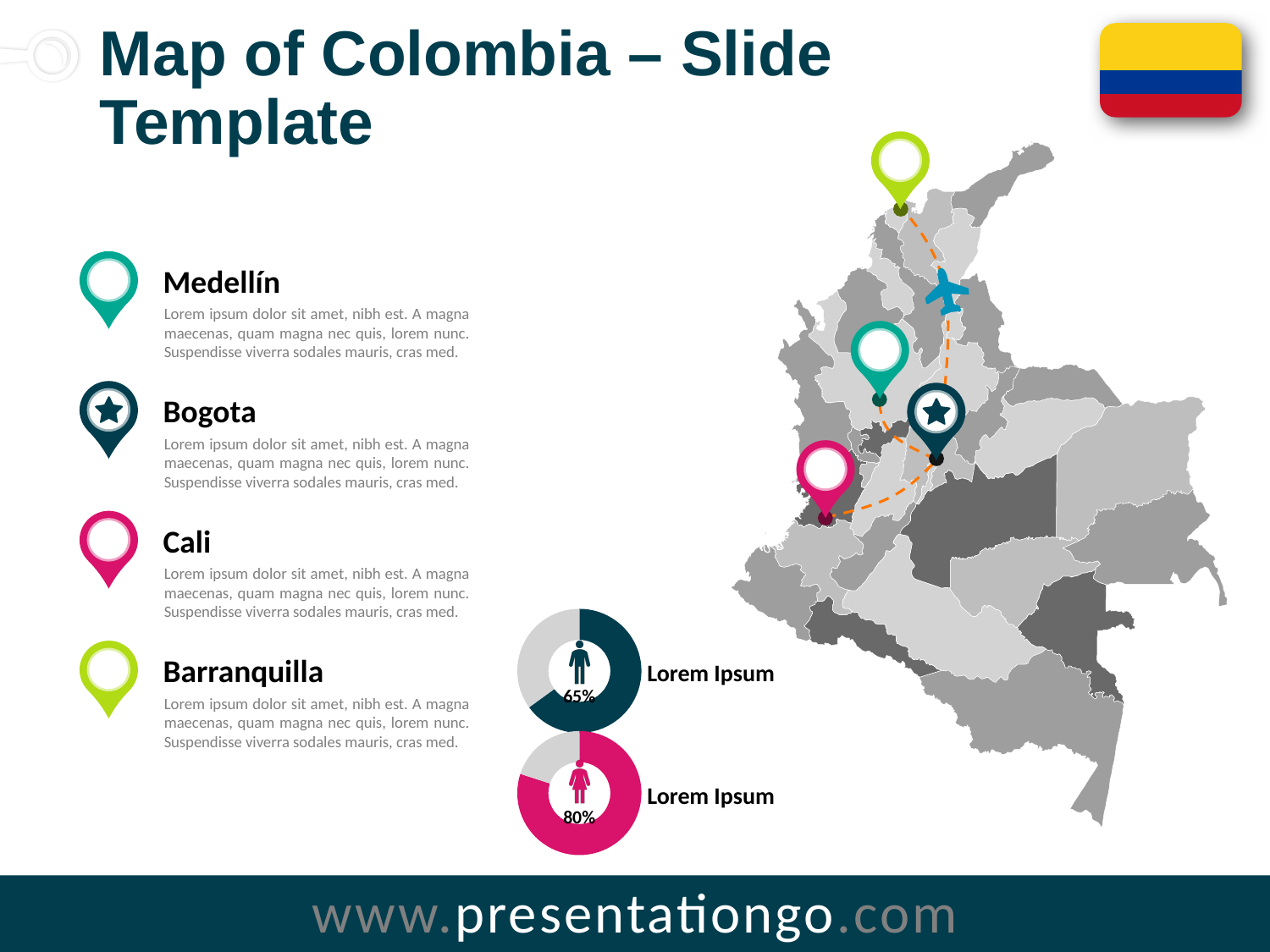
What colour is the filled portion of the lower donut chart with the female figure icon? pink What is the difference between the percentage on the lower donut chart and the percentage on the upper donut chart? 15% Is the value shown on the upper donut chart (male icon) greater or less than 50%? greater What percentage is printed on the upper donut chart with the male figure icon? 65% Is the value shown on the lower donut chart (female icon) greater or less than 75%? greater What percentage is printed on the lower donut chart with the female figure icon? 80% What kind of chart is shown in the upper chart next to the male figure icon? donut chart Which donut chart shows the larger percentage, the upper one (male icon) or the lower one (female icon)? the lower one (female icon) How many donut charts are shown on the slide? 2 What label text appears to the right of each donut chart? Lorem Ipsum